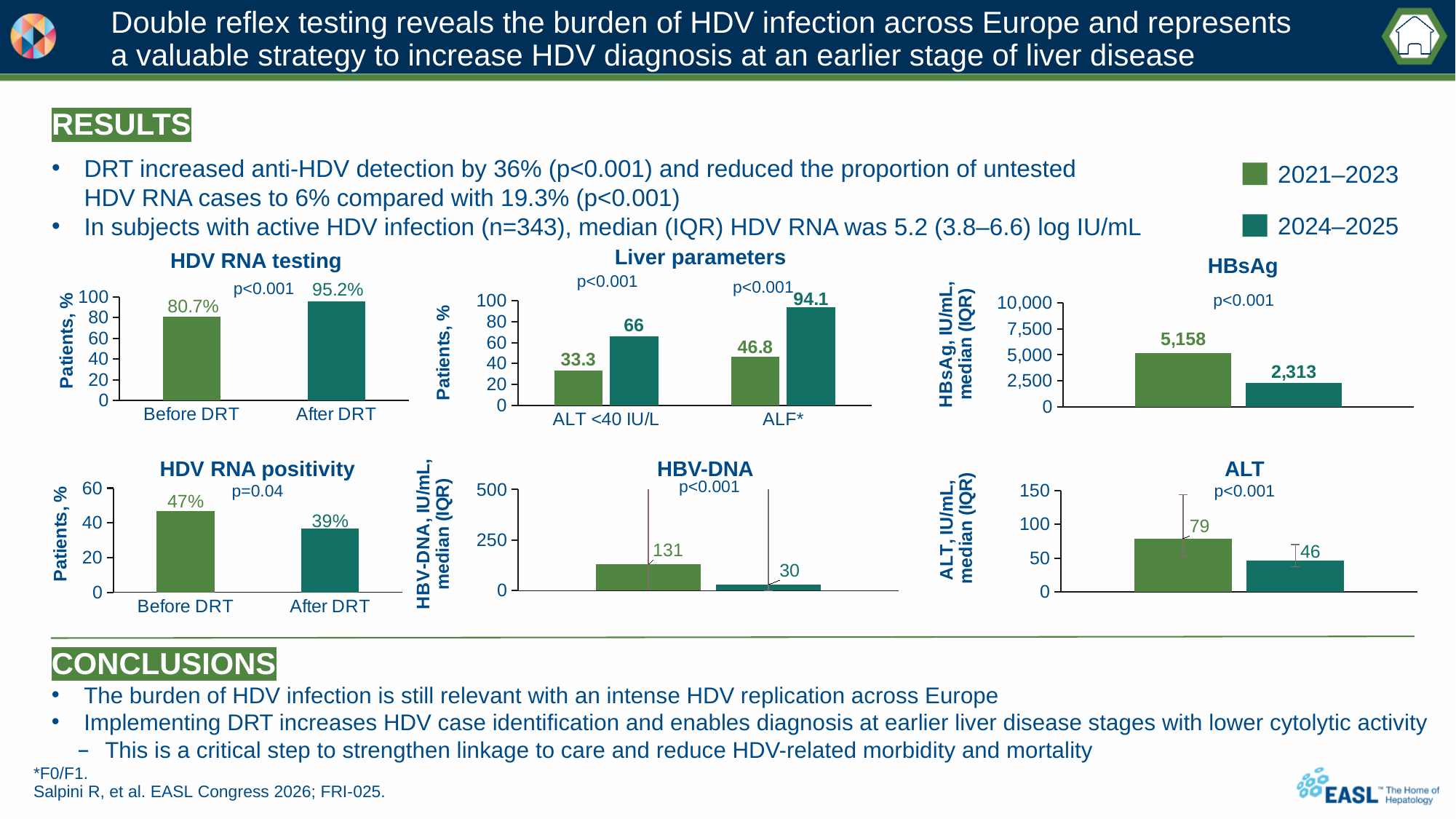
In the Liver parameters chart, how many categories are shown on the x axis? 2 In the HBsAg chart, what is the value for 2021–2023? 5,158 In the HDV RNA testing chart, what is the value for After DRT? 95.2% In the HDV RNA positivity chart, is the value for After DRT greater or less than 40? less How many series does the legend at the top right of the slide list? 2 In the Liver parameters chart, what is the 2021–2023 value for ALT <40 IU/L? 33.3 In the HDV RNA positivity chart, what is the value for Before DRT? 47% In the ALT chart, which is larger, the 2021–2023 value or the 2024–2025 value? 2021–2023 In the Liver parameters chart, what is the 2024–2025 value for ALF*? 94.1 In the HBV-DNA chart, what is the difference between the 2021–2023 and 2024–2025 values? 101 In the HDV RNA testing chart, what is the difference between the After DRT and Before DRT values? 14.5% In the HBsAg chart, which period has the lower median HBsAg? 2024–2025